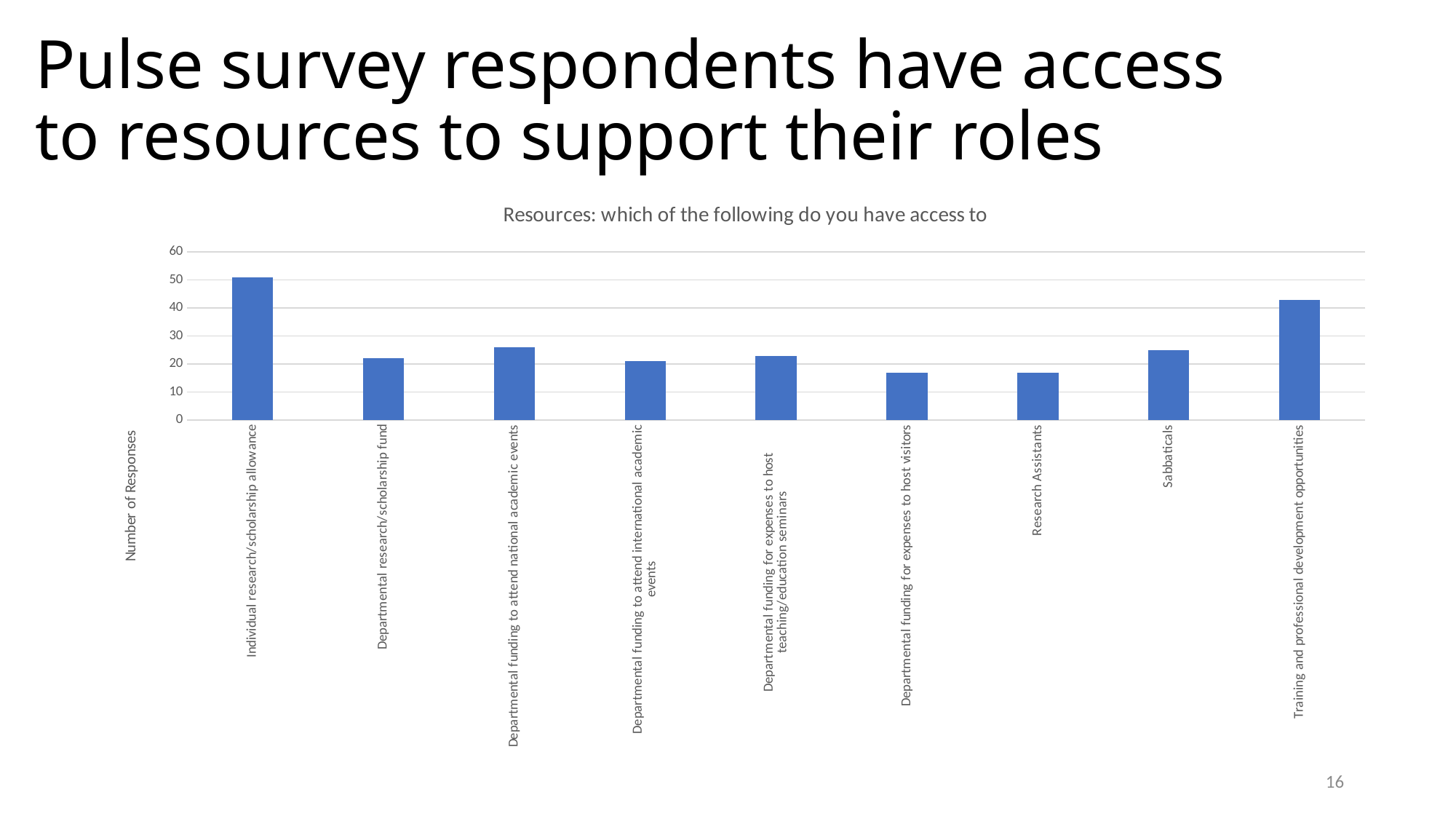
Is the value for Training and professional development opportunities greater or less than 30? greater How many resource categories are plotted on the chart? 9 What kind of chart is shown on the slide? bar chart Is the value for Individual research/scholarship allowance greater or less than 40? greater Is the value for Sabbaticals greater or less than 20? greater Which has more responses: Individual research/scholarship allowance or Training and professional development opportunities? Individual research/scholarship allowance Which has more responses: Sabbaticals or Research Assistants? Sabbaticals Which resource category has the highest number of responses? Individual research/scholarship allowance What is the label on the vertical axis of the chart? Number of Responses What is the title of the chart? Resources: which of the following do you have access to